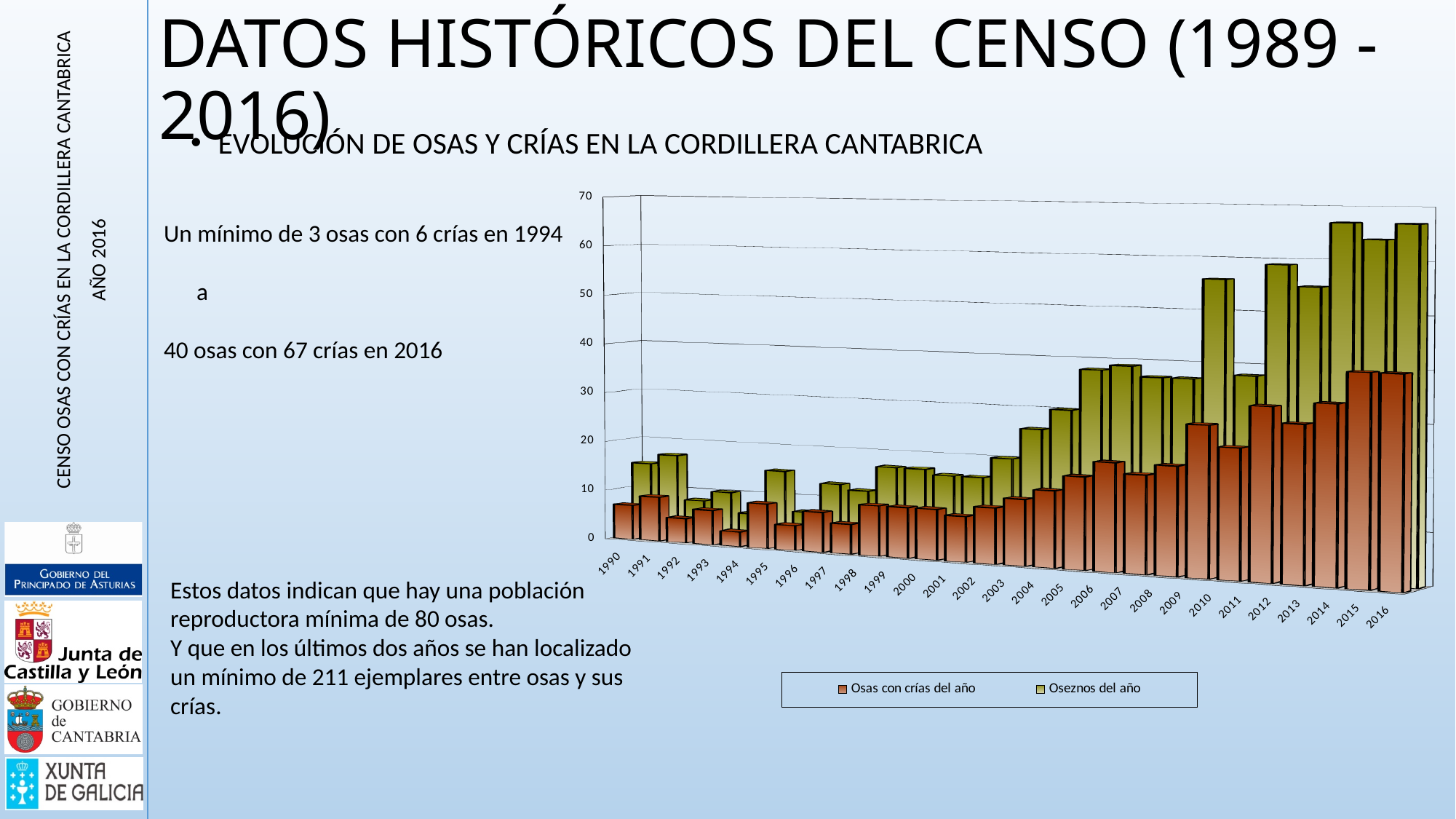
What are the two series named in the chart legend? Osas con crías del año; Oseznos del año Is the value for Osas con crías del año in 1994 greater or less than 10? less Which year is the first on the x axis and which is the last? 1990 and 2016 How many years are shown along the x axis of the chart? 27 Is the value for Oseznos del año in 2006 greater or less than 30? greater Is the value for Oseznos del año in 2015 greater or less than 50? greater How many series does the chart legend list? 2 What kind of chart is shown on the slide? Bar chart Which year has the lowest value for Osas con crías del año? 1994 In 2010, which series has the larger value, Osas con crías del año or Oseznos del año? Oseznos del año Overall, do the values for Oseznos del año rise or fall from 1990 to 2016? rise